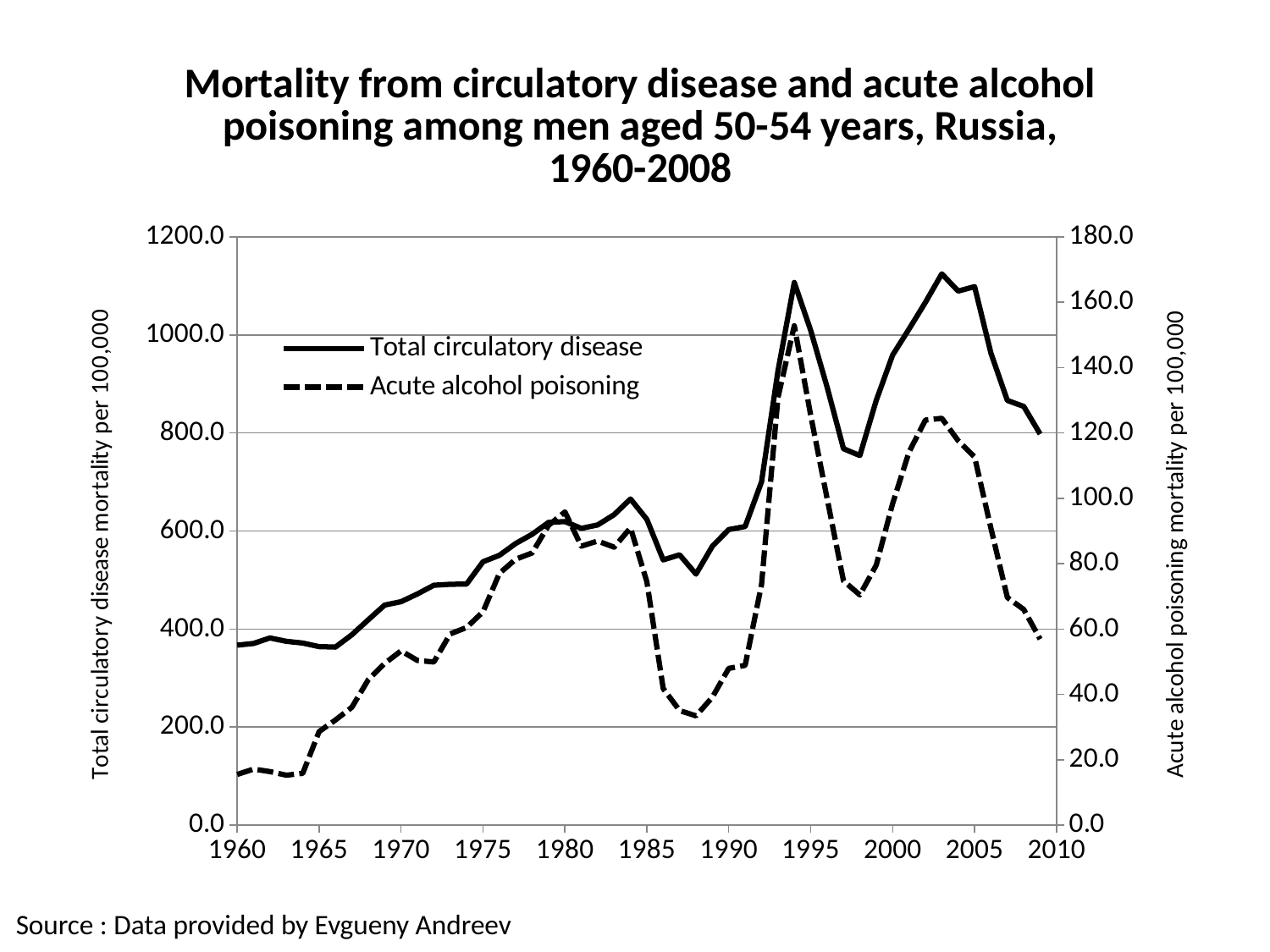
Is the value for Acute alcohol poisoning in 1994 greater or less than 140? greater Is the value for Acute alcohol poisoning in 2003 greater or less than 100? greater Which series is drawn with a dashed line? Acute alcohol poisoning In which year does Acute alcohol poisoning reach its highest value? 1994 Is the value for Acute alcohol poisoning in 1988 greater or less than 40? less How many series does the legend list? 2 What kind of chart is shown on the slide? line chart What is the label of the right-hand vertical axis? Acute alcohol poisoning mortality per 100,000 Which is larger for Total circulatory disease: the value in 1994 or the value in 1998? 1994 Does Total circulatory disease rise or fall between 1960 and 1980? rise